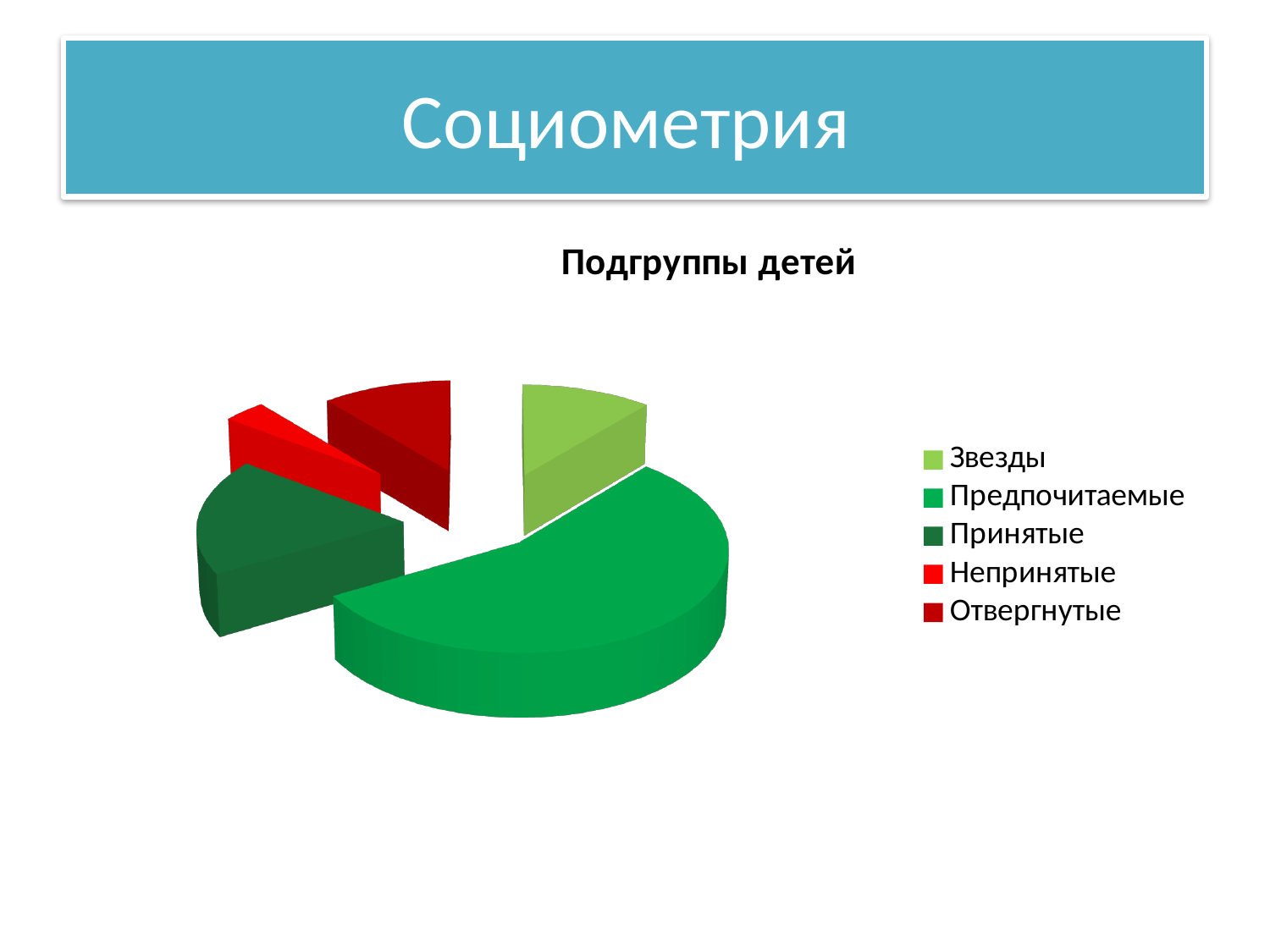
What is the title of the chart? Подгруппы детей Which is larger, the slice for Предпочитаемые or the slice for Принятые? Предпочитаемые Which category is shown in light green in the legend? Звезды How many categories does the pie chart have? 5 Which is larger, the slice for Принятые or the slice for Непринятые? Принятые Which is larger, the slice for Предпочитаемые or the slice for Звезды? Предпочитаемые Which category has the largest slice of the pie? Предпочитаемые What kind of chart is shown on the slide? Pie chart How many entries does the legend list? 5